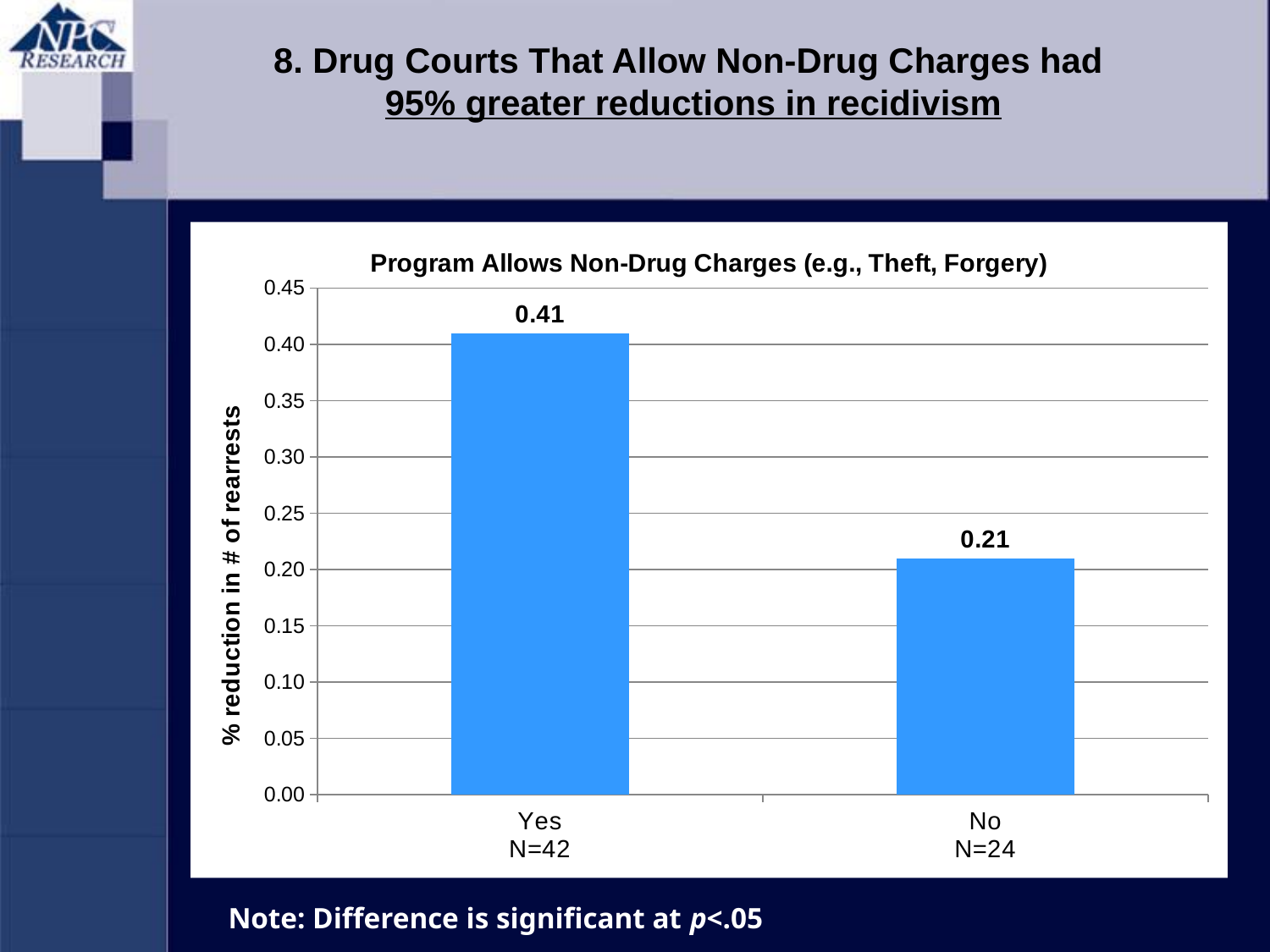
What is the title of the chart? Program Allows Non-Drug Charges (e.g., Theft, Forgery) What is the difference between the values for "Yes" and "No"? 0.20 Is the value for "No" greater or less than 0.25? less Which category has the lowest value? No What is the value for the "No" category? 0.21 Which is larger, the value for "Yes" or the value for "No"? Yes What is the label of the y axis? % reduction in # of rearrests Which category has the highest value? Yes How many categories are shown on the x axis? 2 Is the value for "Yes" greater or less than 0.40? greater What is the value for the "Yes" category? 0.41 What kind of chart is shown on the slide? bar chart